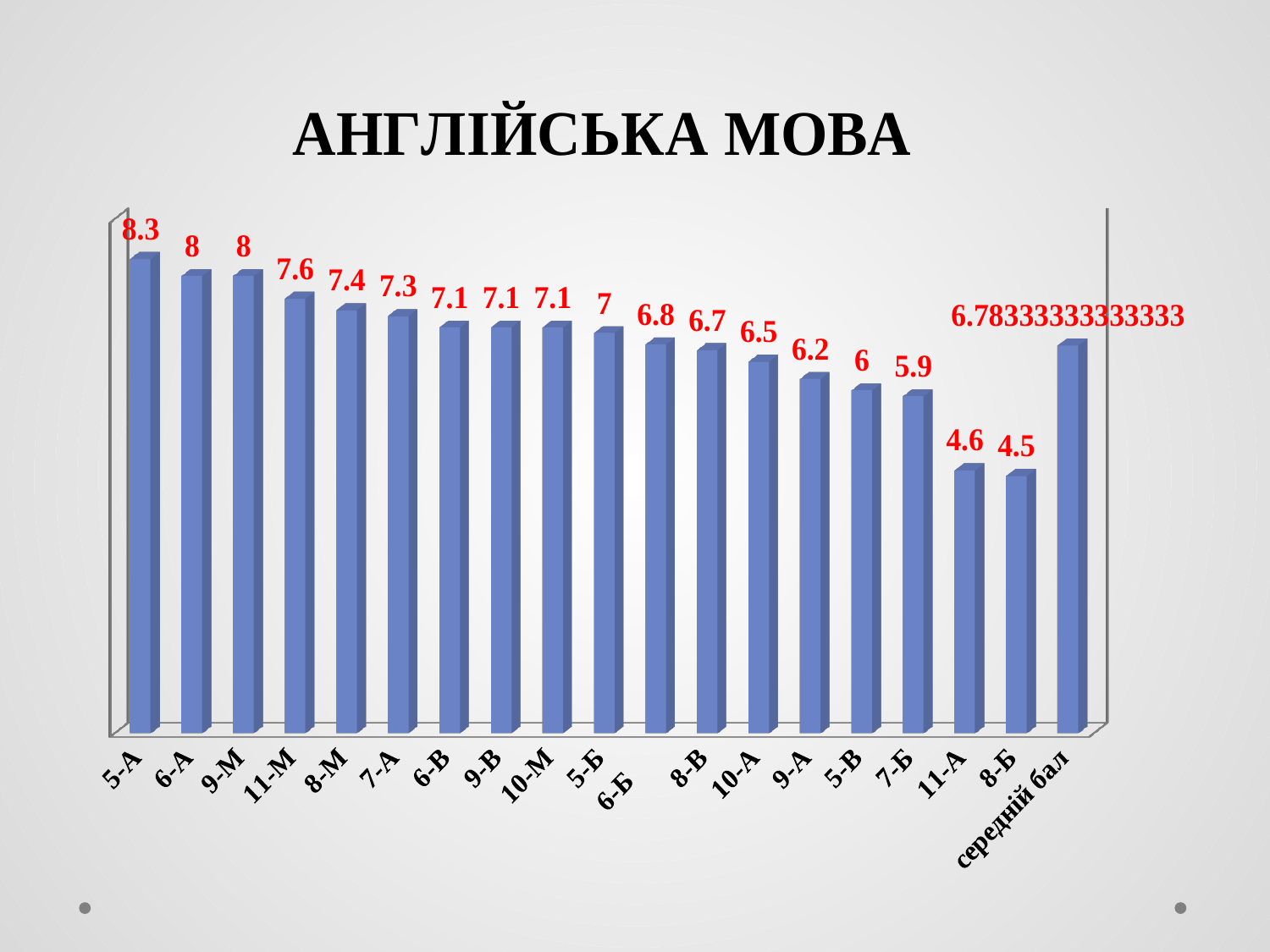
Which category has the highest value? 5-А What kind of chart is shown on the slide? bar chart What is the difference between the values for 5-А and 8-Б? 3.8 Which is larger, the value for 10-А or the value for 9-А? 10-А What is the value for 5-А? 8.3 What is the difference between the values for 11-М and 7-Б? 1.7 What is the value for 8-Б? 4.5 What is the title of the chart? АНГЛІЙСЬКА МОВА What is the value shown for середній бал? 6.78333333333333 Which category has the lowest value? 8-Б What is the value for 11-М? 7.6 How many bars are plotted in the chart? 19